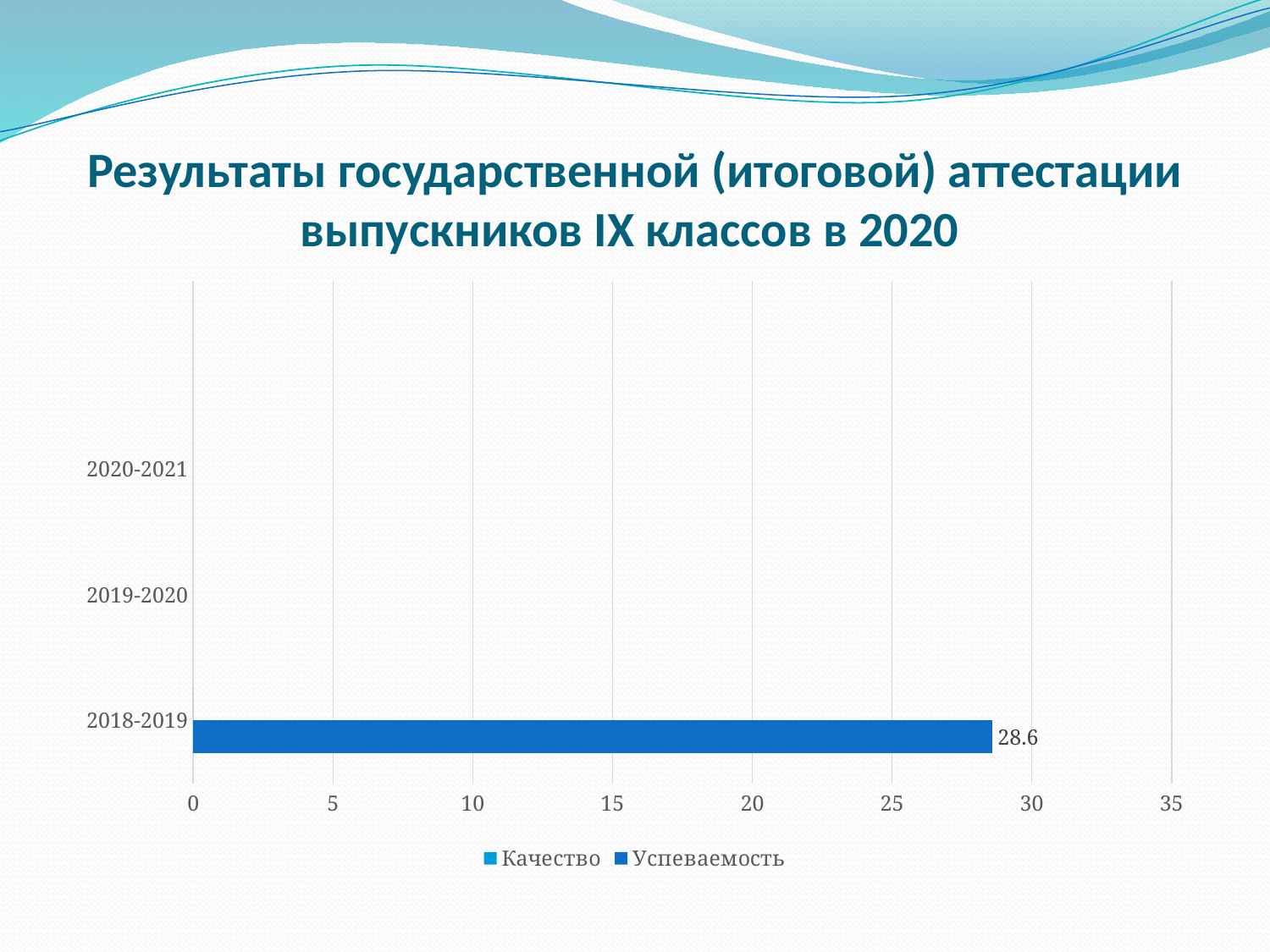
What is the value of the bar shown for 2018-2019? 28.6 What is the highest value shown on the horizontal axis? 35 How many series does the legend list? 2 Is the value for 2018-2019 greater or less than 25? greater Is the value for 2018-2019 greater or less than 30? less How many categories are listed on the vertical axis of the chart? 3 What are the two series named in the legend? Качество and Успеваемость Which category has a bar plotted in the chart? 2018-2019 What kind of chart is shown on the slide? bar chart